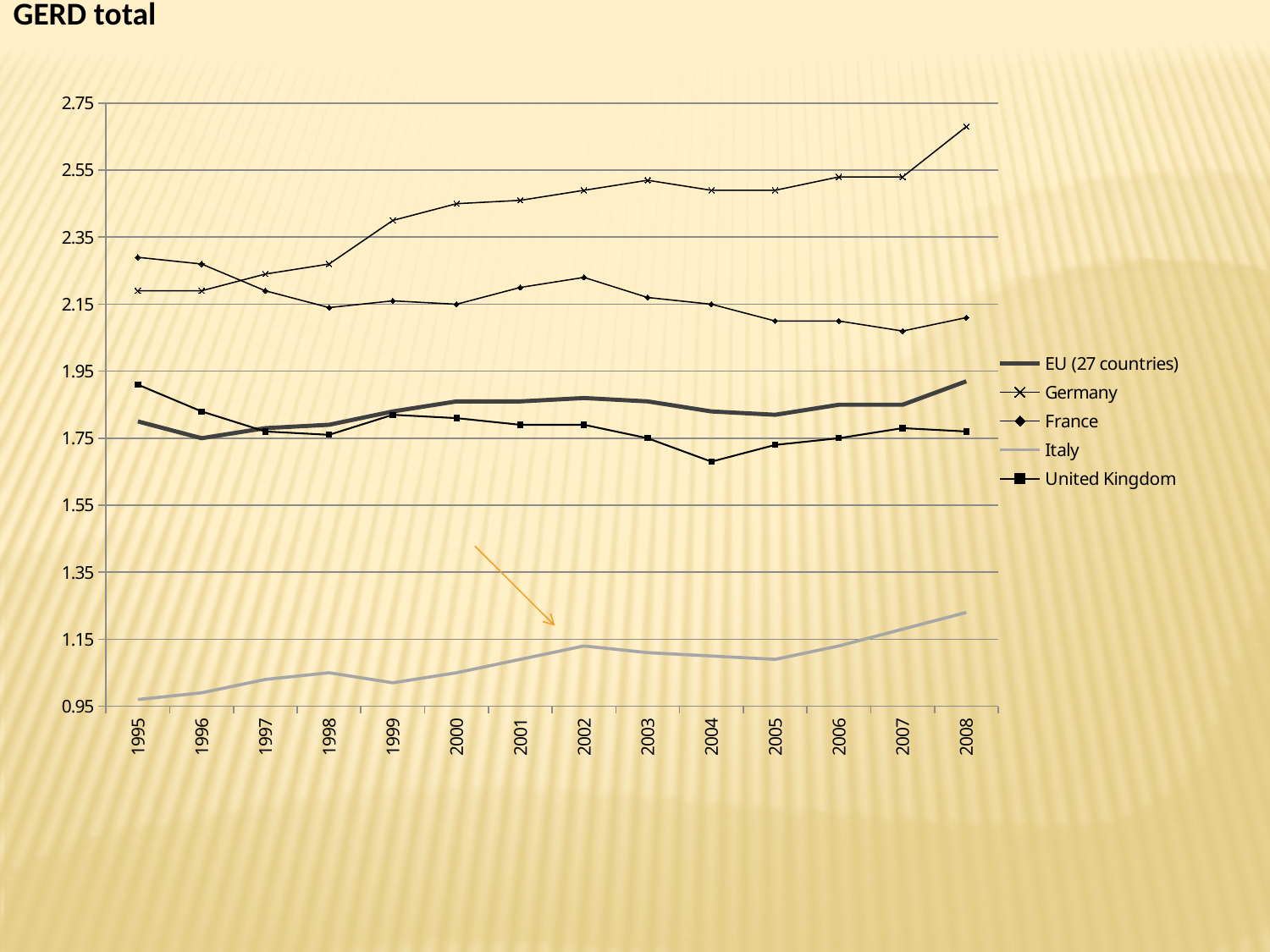
Which series has the lowest values across all years? Italy Is the value for Italy in 1995 greater or less than 1.15? less What kind of chart is shown on the slide? Line chart How many series does the legend list? 5 Is the value for Germany in 2008 greater or less than 2.55? greater In which year is the United Kingdom at its lowest value? 2004 Which series has the highest value in 2008? Germany Which is larger in 1995, the value for France or the value for Germany? France Is the value for the United Kingdom in 2004 greater or less than 1.75? less How many years are shown on the x axis? 14 In which year does Germany reach its highest value? 2008 Does the Italy line generally rise or fall from 1995 to 2008? rise